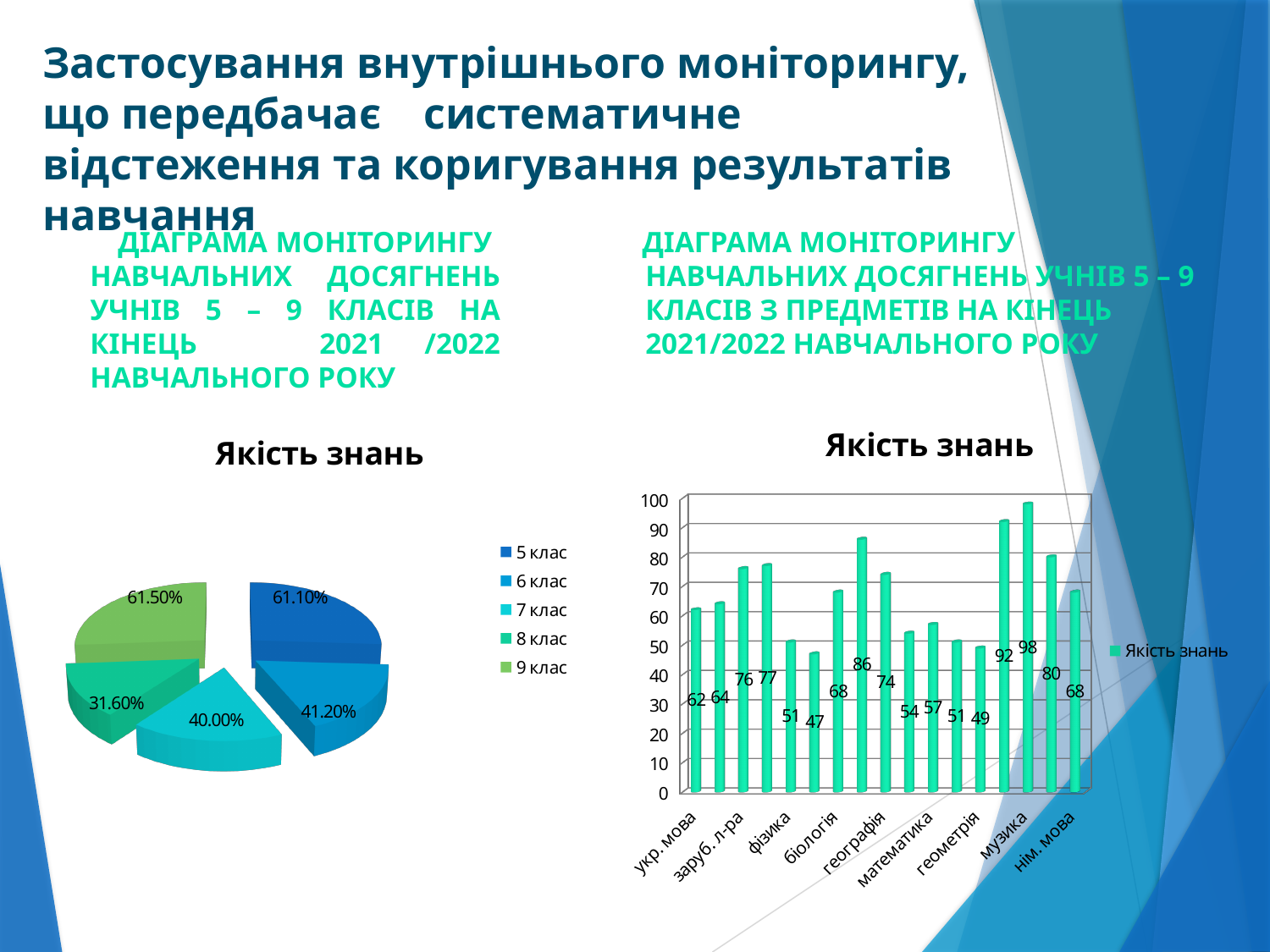
On the left pie chart, which class has the lowest value? 8 клас On the left pie chart, what is the difference between the values for 5 клас and 6 клас? 19.90% On the left pie chart, what is the value for 7 клас? 40.00% What is the title of the right bar chart? Якість знань On the left pie chart, which class has the highest value? 9 клас What kind of chart is the chart on the right of the slide? Bar chart What kind of chart is the chart on the left of the slide? Pie chart On the left pie chart, what is the value for 8 клас? 31.60% On the left pie chart, which is larger: the value for 6 клас or 7 клас? 6 клас How many classes does the legend of the left pie chart list? 5 On the left pie chart, what is the value for 5 клас? 61.10%